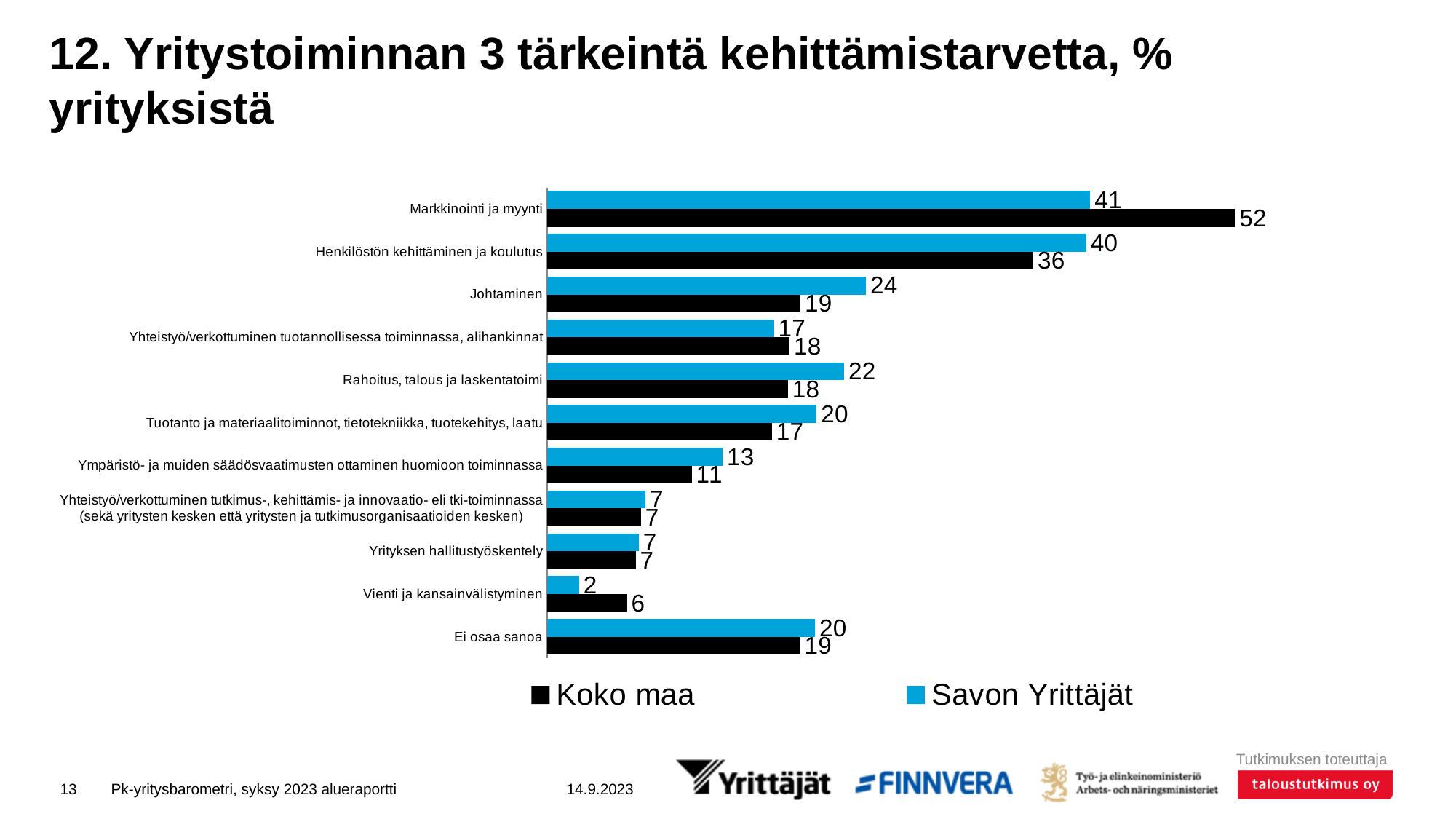
What is the value for Savon Yrittäjät for Henkilöstön kehittäminen ja koulutus? 40 What is the value for Koko maa for Markkinointi ja myynti? 52 How many series does the legend list? 2 How many categories are shown on the chart? 11 What is the difference between the Koko maa and Savon Yrittäjät values for Markkinointi ja myynti? 11 What is the value for Koko maa for Ei osaa sanoa? 19 For Johtaminen, which series has the larger value, Koko maa or Savon Yrittäjät? Savon Yrittäjät Which colour represents the Savon Yrittäjät series? blue Which category has the highest value for Koko maa? Markkinointi ja myynti What type of chart is shown on the slide? bar chart What is the value for Savon Yrittäjät for Vienti ja kansainvälistyminen? 2 Which category has the lowest value for Savon Yrittäjät? Vienti ja kansainvälistyminen